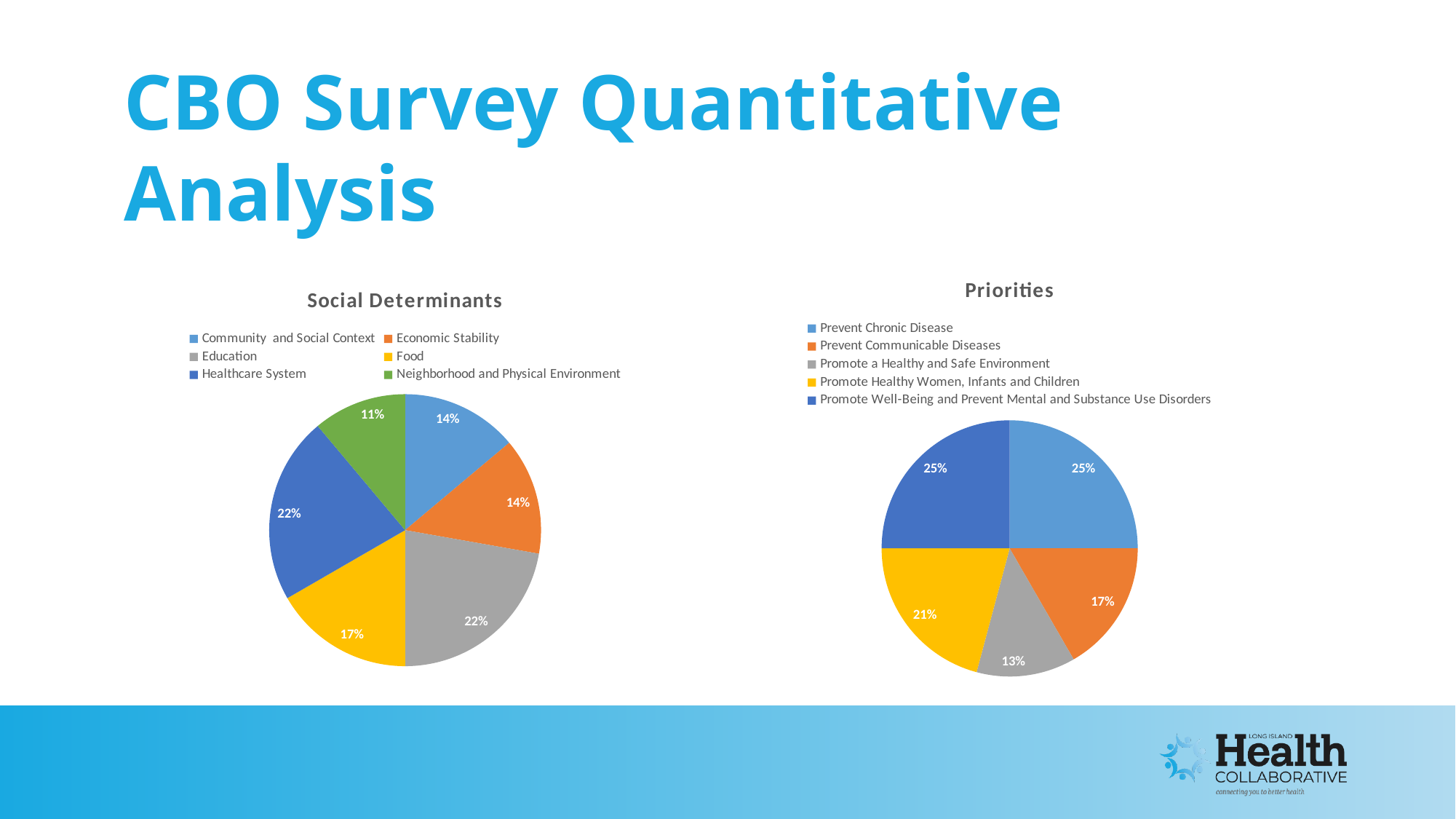
In the Social Determinants chart, which category has the smallest share? Neighborhood and Physical Environment In the Priorities chart, what share does Prevent Communicable Diseases have? 17% How many categories does the Social Determinants chart show? 6 In the Priorities chart, what is the difference between the shares for Prevent Chronic Disease and Promote a Healthy and Safe Environment? 12% What type of chart is the Priorities chart? Pie chart In the Social Determinants chart, which is larger: Healthcare System or Food? Healthcare System In the Social Determinants chart, what share does Food have? 17% In the Priorities chart, which category has the smallest share? Promote a Healthy and Safe Environment How many entries does the legend of the Priorities chart list? 5 In the Priorities chart, what share does Promote Healthy Women, Infants and Children have? 21% In the Social Determinants chart, what is the difference between the shares for Education and Economic Stability? 8%